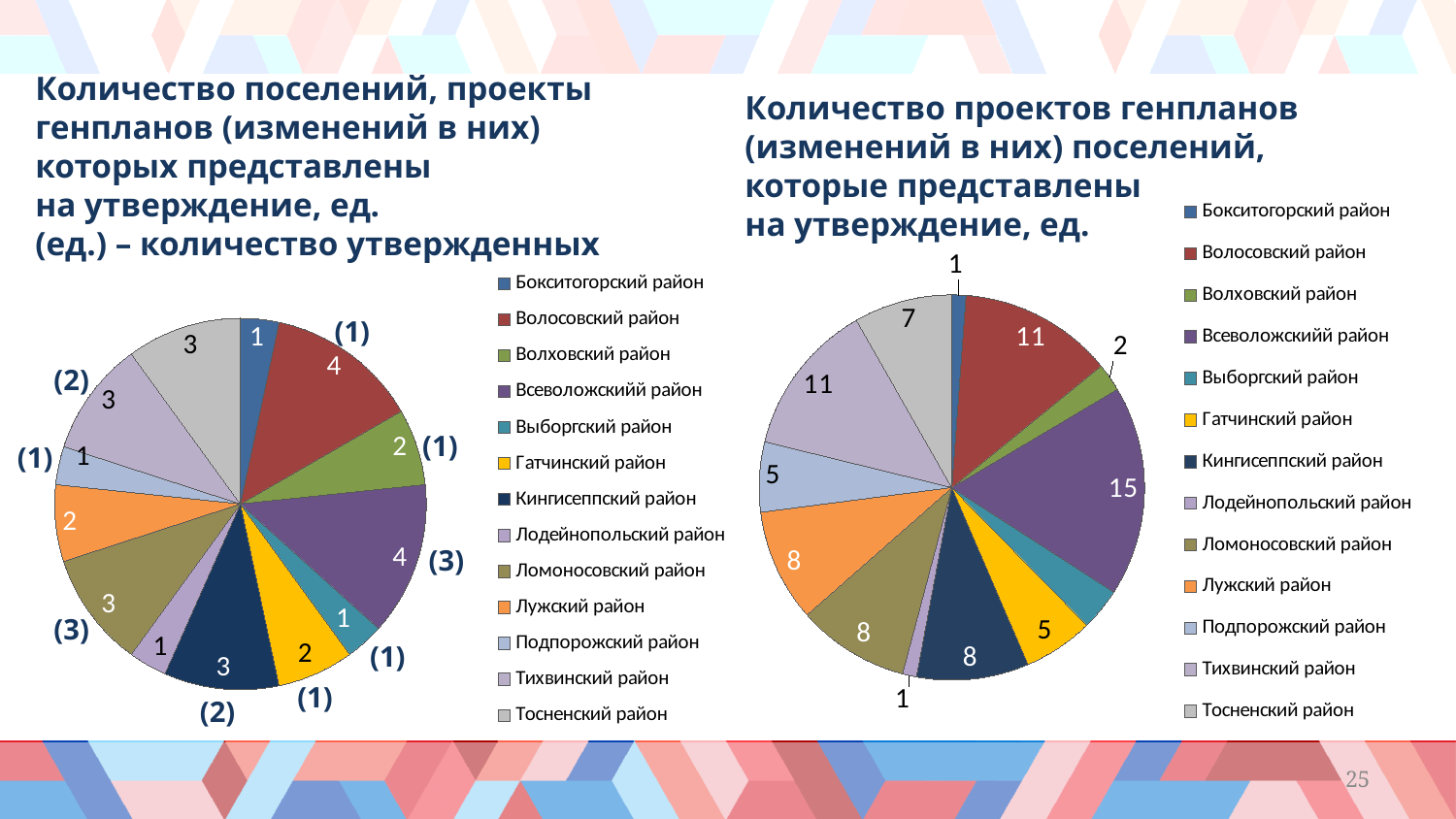
In the right chart, what is the difference between the values for Всеволожский район and Тосненский район? 8 In the left chart, what is the value for Кингисеппский район? 3 How many slices does the left pie chart have? 13 In the left chart, what number in parentheses (количество утвержденных) is shown for Ломоносовский район? (3) In the right chart, what is the value for Волосовский район? 11 How many districts does the legend of the right chart list? 13 In the right chart, which is larger: the value for Лужский район or for Подпорожский район? Лужский район What kind of chart is the left chart, 'Количество поселений, проекты генпланов (изменений в них) которых представлены на утверждение'? Pie chart In the left chart, what is the value for Волосовский район? 4 In the right chart, what is the value for Тихвинский район? 11 In the right chart, 'Количество проектов генпланов (изменений в них) поселений', what is the value for Всеволожский район? 15 In the right chart, which district has the largest slice? Всеволожский район